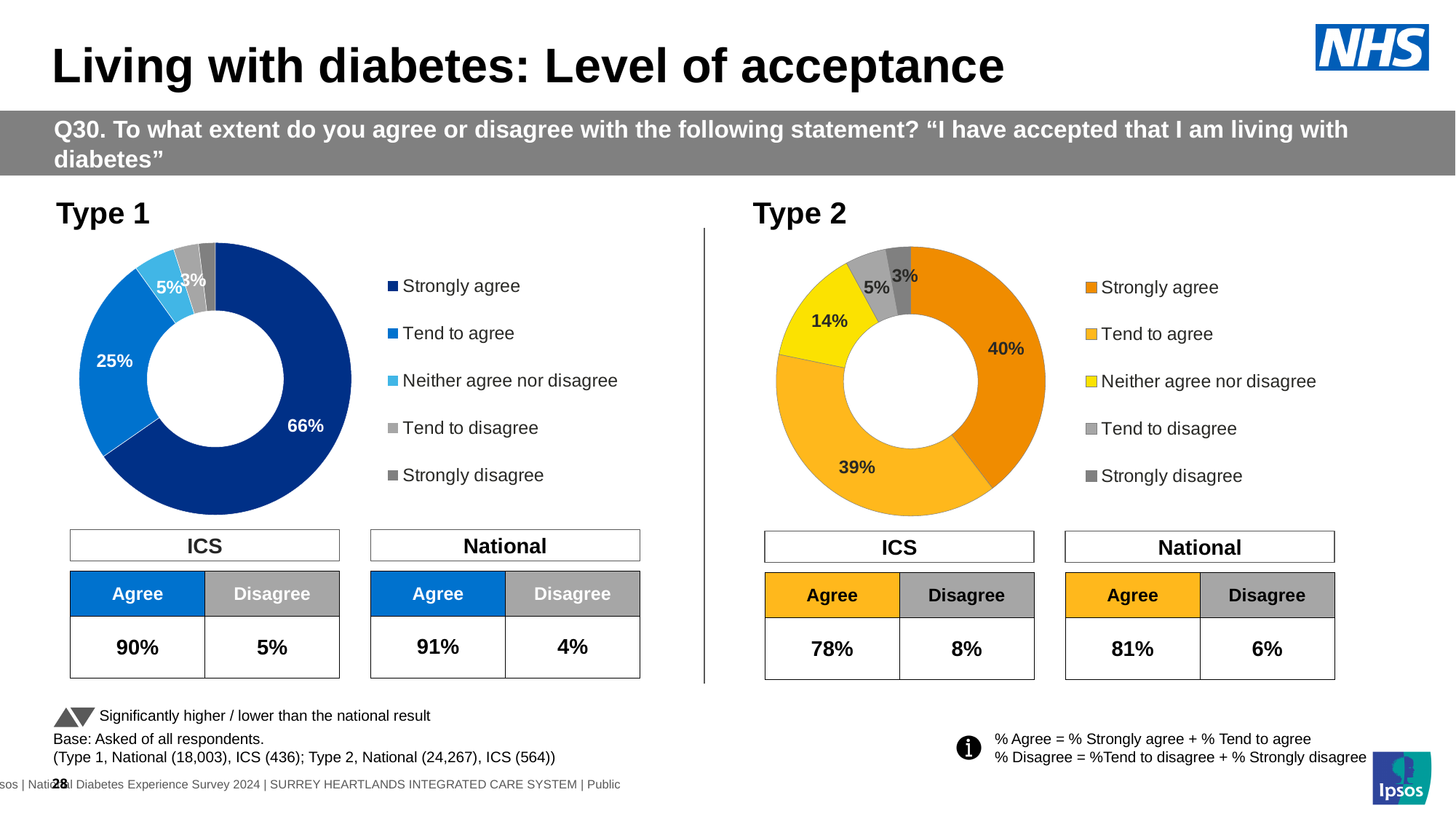
How many response categories does the legend of the Type 2 chart list? 5 In the Type 1 chart, is the Strongly agree share larger or smaller than the Tend to agree share? Larger In the Type 1 chart, what percentage of respondents tend to agree? 25% In the Type 2 chart, what is the difference between the Strongly agree and Tend to agree shares? 1% What kind of chart is used for Type 1? Donut (pie) chart In the Type 2 chart, what percentage of respondents strongly disagree? 3% In the Type 2 chart, what percentage of respondents neither agree nor disagree? 14% In the Type 1 chart, what percentage of respondents strongly agree? 66% In the Type 1 chart, which response category has the largest share? Strongly agree In the Type 2 chart, what percentage of respondents strongly agree? 40% In the Type 1 chart, what colour represents Strongly agree? Dark blue In the Type 2 chart, which response category has the smallest share? Strongly disagree